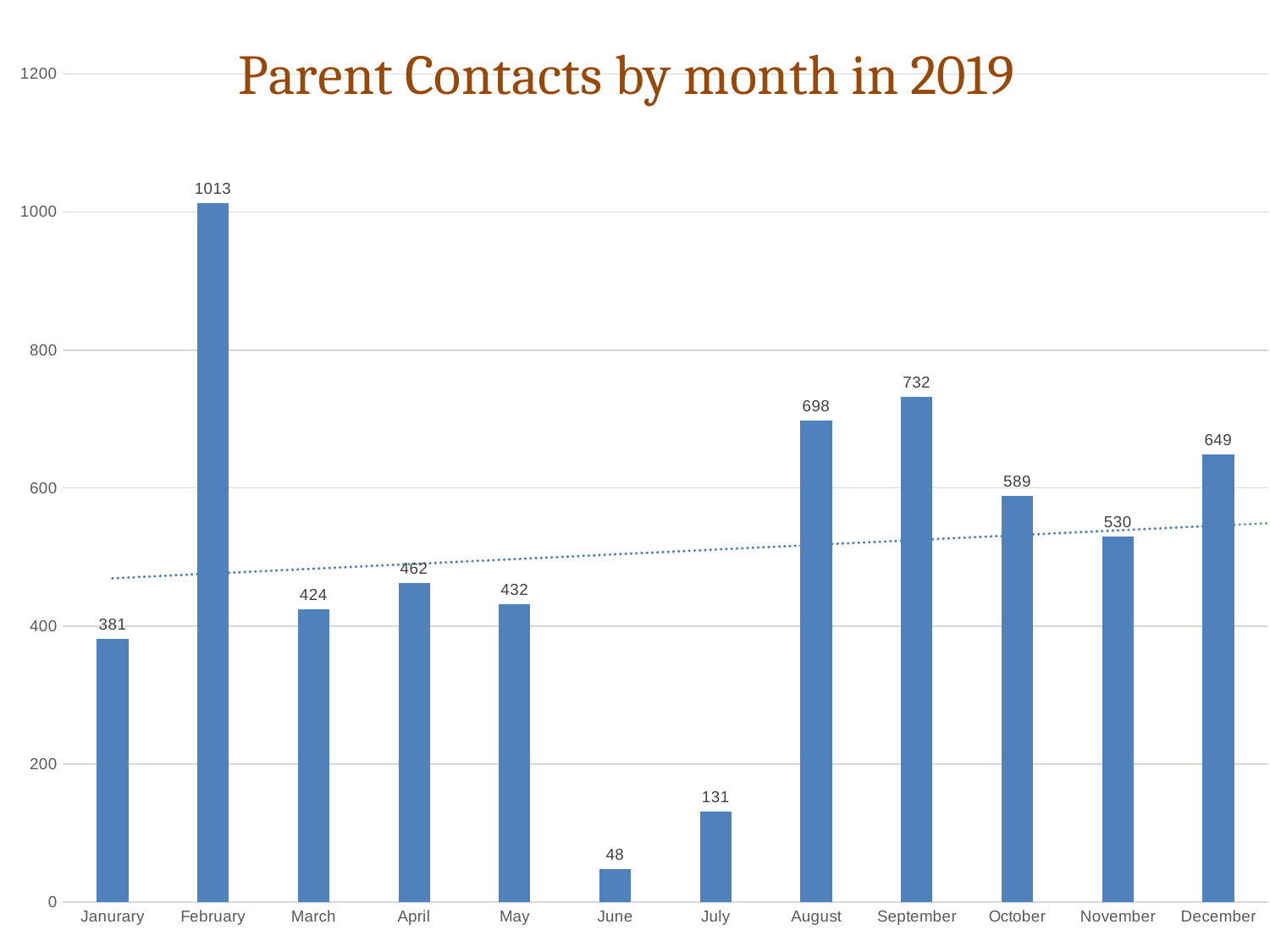
Which is larger, the value for October or the value for November? October Which month has the highest number of parent contacts? February Is the value for December greater or less than 600? greater How many months are shown on the x axis? 12 What is the title of the chart? Parent Contacts by month in 2019 Which month has the lowest number of parent contacts? June What is the value for February? 1013 What is the difference between the values for August and July? 567 What is the value for September? 732 What is the value for June? 48 What kind of chart is shown on the slide? bar chart Do the values rise or fall from June to September? rise